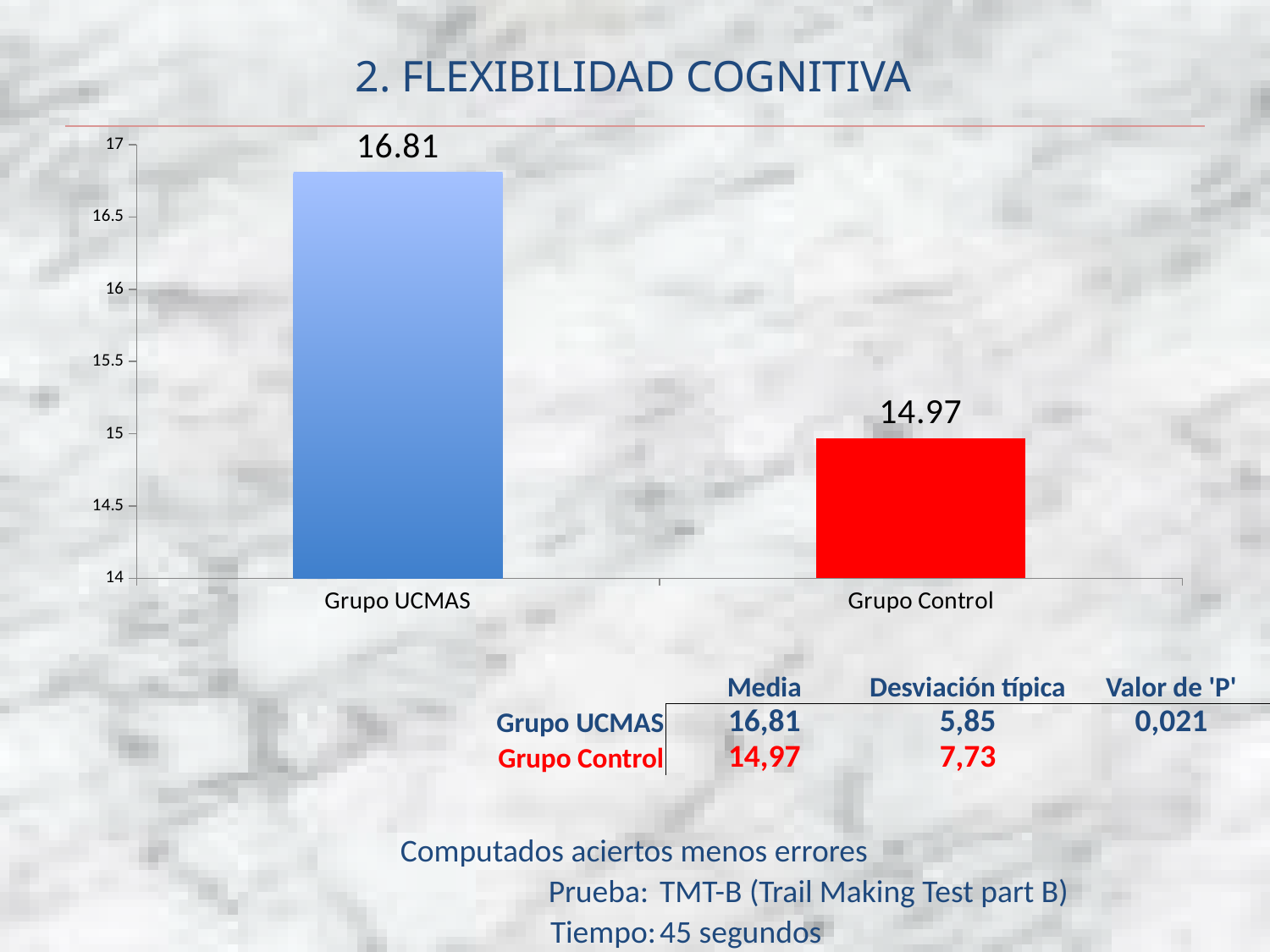
Which group has the highest value? Grupo UCMAS What colour is the bar for Grupo Control? red What is the value for Grupo UCMAS? 16.81 Which group has the lowest value? Grupo Control What kind of chart is shown on the slide? bar chart What is the title of the slide containing the chart? 2. FLEXIBILIDAD COGNITIVA How many categories are shown on the chart? 2 Which is larger, the value for Grupo UCMAS or the value for Grupo Control? Grupo UCMAS Is the value for Grupo UCMAS greater or less than 16.5? greater What is the value for Grupo Control? 14.97 Is the value for Grupo Control greater or less than 15? less What is the difference between the values for Grupo UCMAS and Grupo Control? 1.84